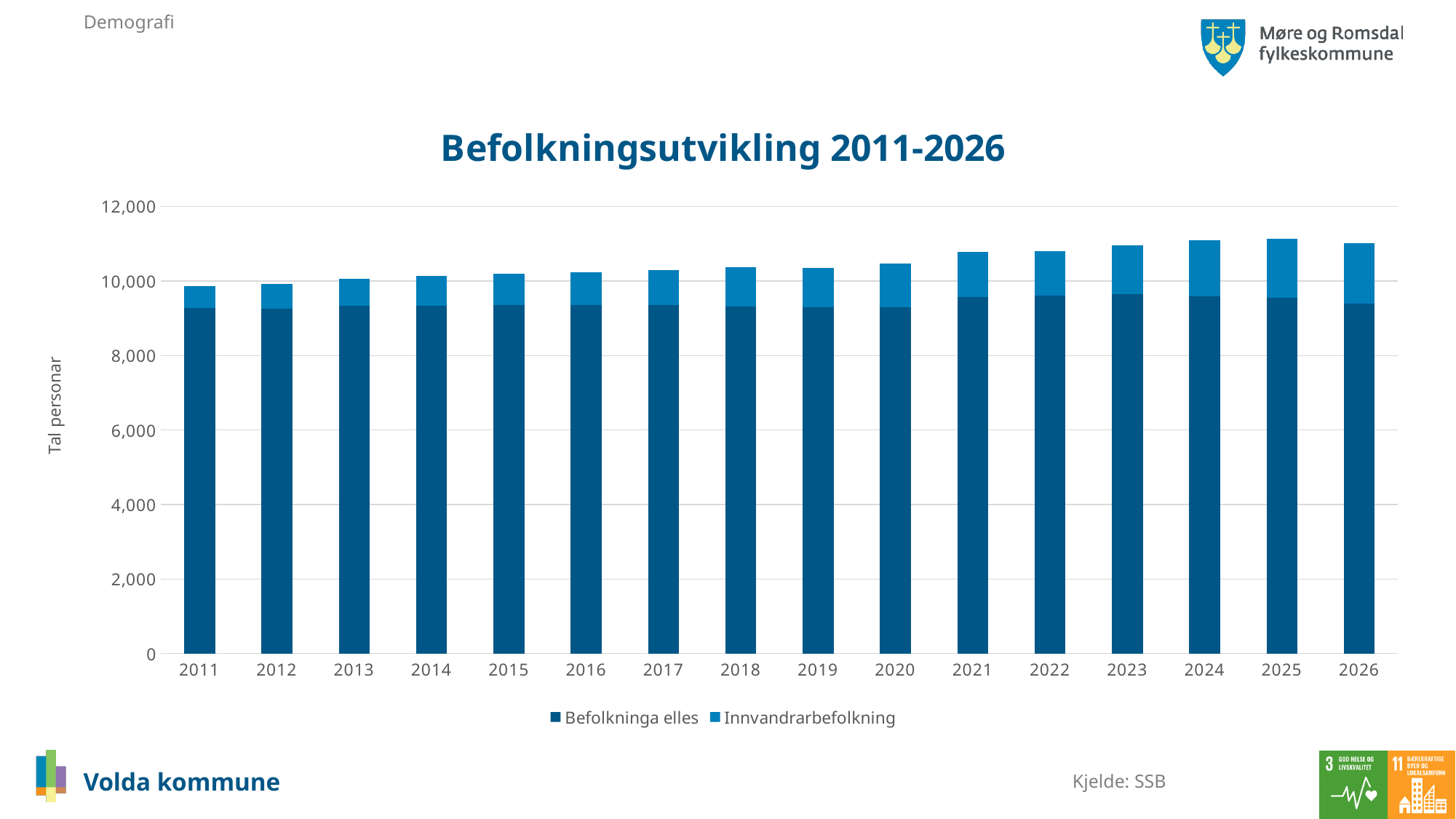
Is the total bar for 2011 greater or less than 8,000? greater How many series does the legend list? 2 What kind of chart is shown on the slide? bar chart Is the value for Befolkninga elles in 2011 greater or less than 10,000? less What is the title of the chart? Befolkningsutvikling 2011-2026 How many years are shown along the x axis? 16 Which year has the lowest total bar? 2011 Do the total bars generally rise or fall from 2011 to 2026? rise What are the two series named in the legend? Befolkninga elles and Innvandrarbefolkning Is the total bar for 2021 greater or less than 10,000? greater Which total bar is larger, 2011 or 2026? 2026